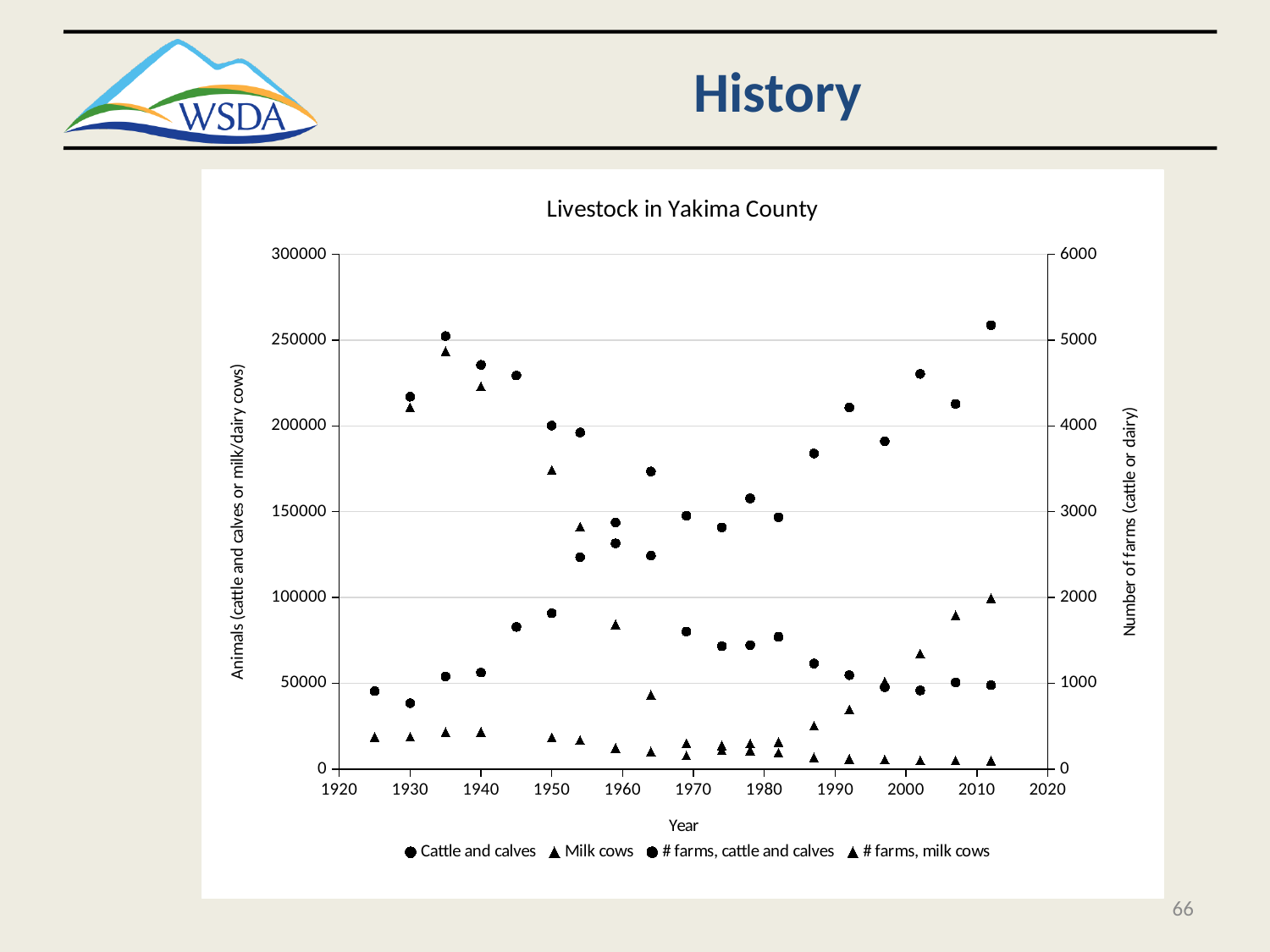
Which series are listed in the chart legend? Cattle and calves; Milk cows; # farms, cattle and calves; # farms, milk cows Is the highest plotted point on the chart greater or less than 250000 on the left axis? greater What is the title of the chart? Livestock in Yakima County How many series does the legend list? 4 What kind of chart is shown on the slide? scatter chart